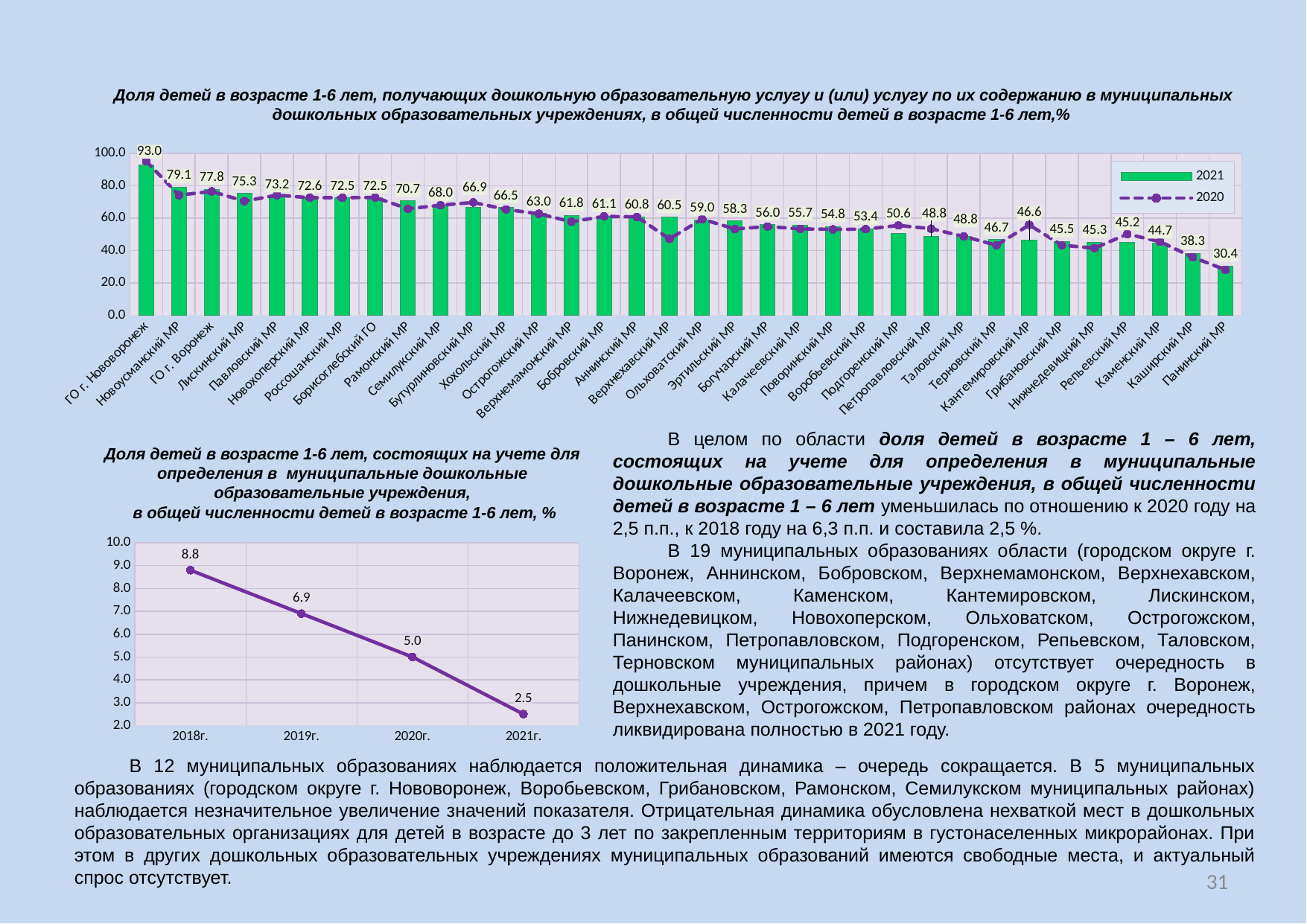
In the bottom-left chart, do the values rise or fall from 2018г. to 2021г.? fall In the top bar chart, what is the 2021 value for Панинский МР? 30.4 In the bottom-left chart, how many data points are plotted? 4 In the top chart, which series is shown as a dashed line with markers? 2020 In the top bar chart, which category has the highest 2021 value? ГО г. Нововоронеж In the bottom-left chart, what is the value for 2021г.? 2.5 In the top bar chart, which has the larger 2021 value: Каширский МР or Каменский МР? Каменский МР In the bottom-left chart, what is the difference between the values for 2018г. and 2021г.? 6.3 In the top bar chart, how many series does the legend list? 2 In the top bar chart, what is the 2021 value for ГО г. Нововоронеж? 93.0 In the top bar chart, what is the difference between the 2021 values for ГО г. Воронеж and Лискинский МР? 2.5 In the top bar chart, which category has the lowest 2021 value? Панинский МР